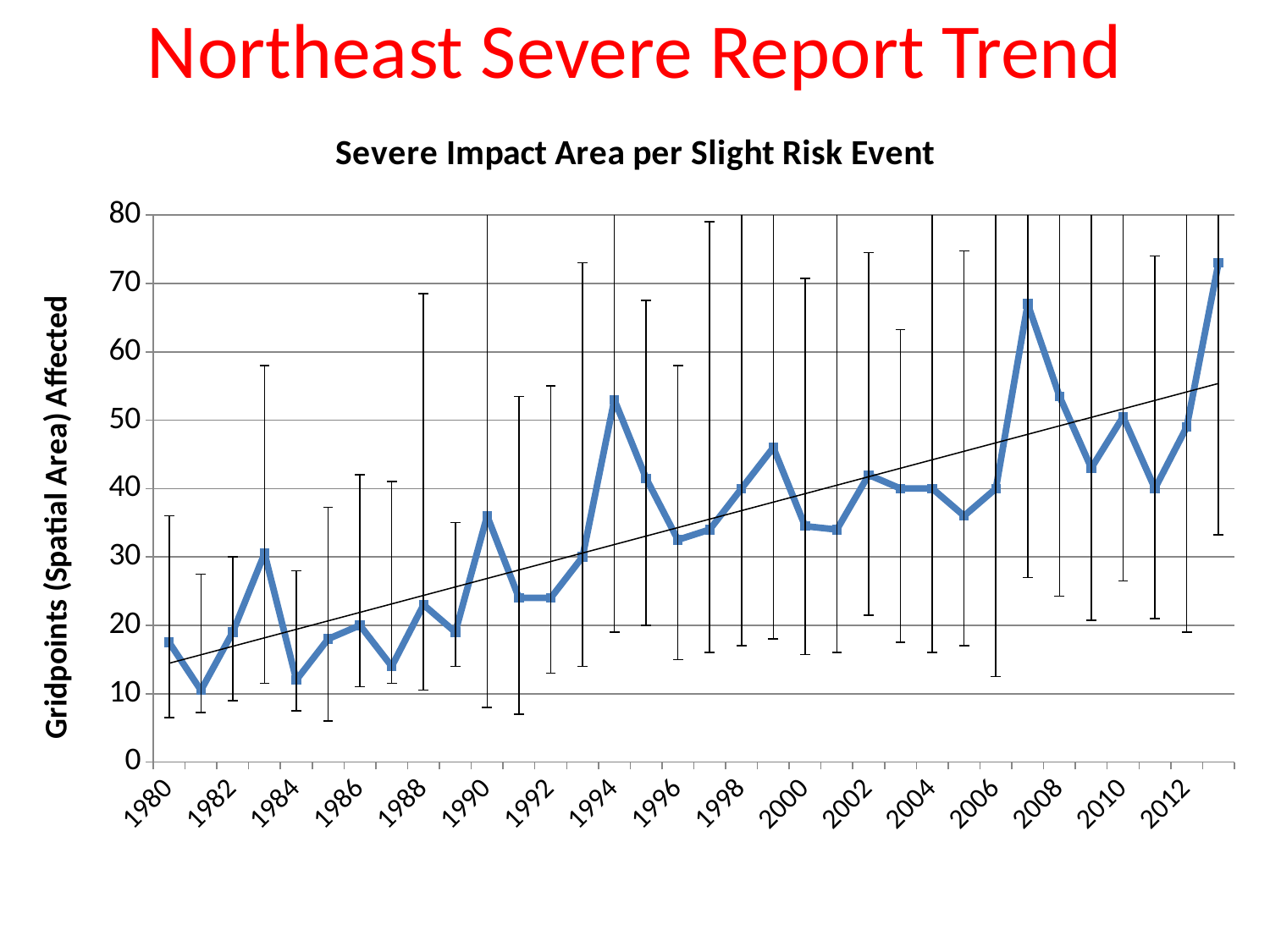
Is the value for 2007 greater or less than 60? greater Overall, do the values rise or fall from 1980 to 2013? Rise What is the title of the chart? Severe Impact Area per Slight Risk Event What is the label on the vertical axis of the chart? Gridpoints (Spatial Area) Affected Is the value for 1990 greater or less than 30? greater Which year has the larger value, 1994 or 2007? 2007 Is the value for 1996 greater or less than 40? less Which year has the larger value, 1983 or 1990? 1990 What kind of chart is shown on the slide? Line chart Which year has the highest value on the chart? 2013